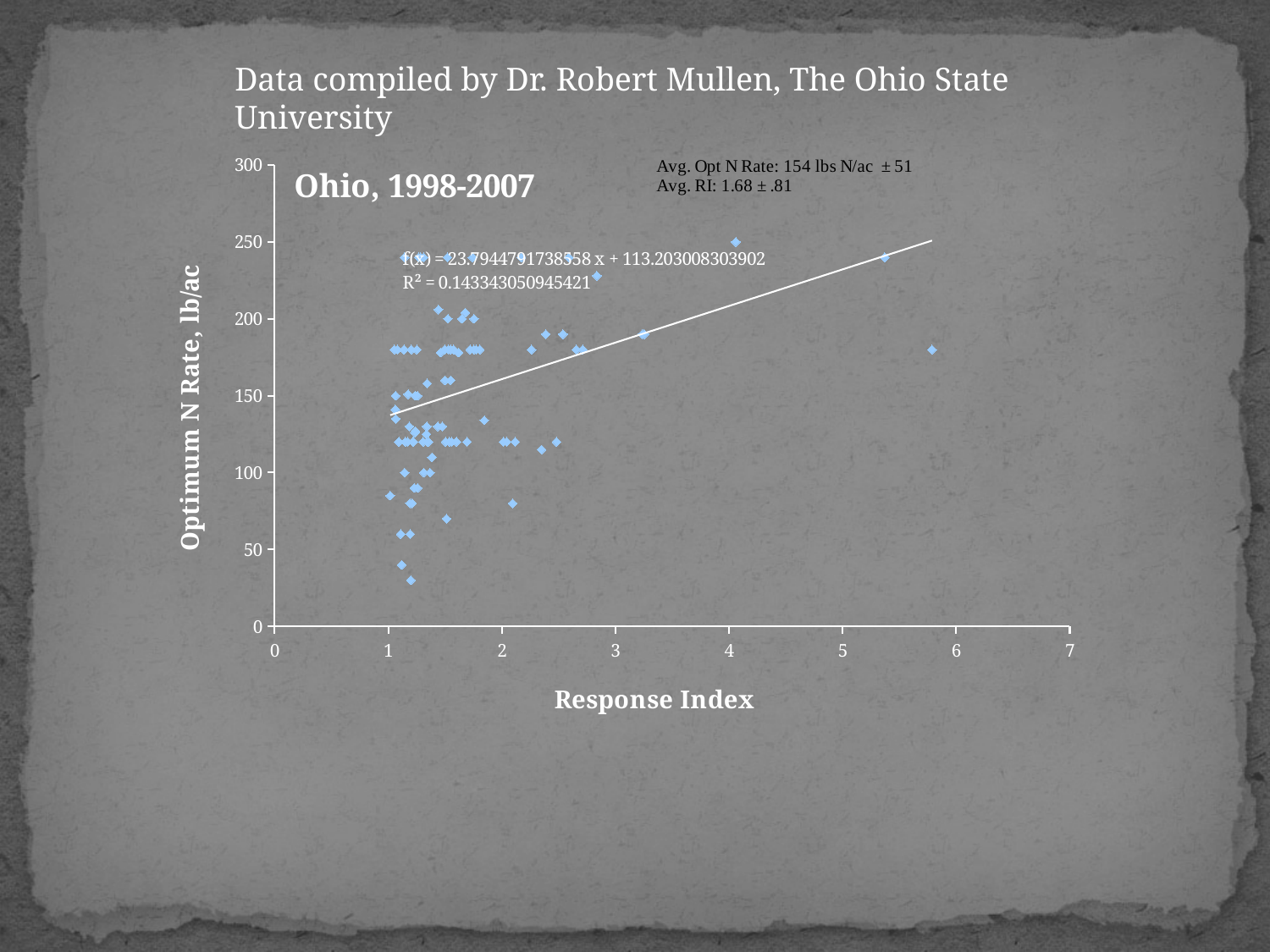
Is the Optimum N Rate of the data point at a Response Index of about 5.8 greater or less than 150? greater What is the intercept of the trendline equation printed on the chart? 113.203008303902 Does the fitted trendline rise or fall as the Response Index increases? Rises What kind of chart is shown on the slide? Scatter chart What R² value is printed on the chart for the trendline? R² = 0.143343050945421 What is the slope of the trendline equation printed on the chart? 23.7944791738558 What is the title of the chart? Ohio, 1998-2007 What is the label of the x axis? Response Index What average Response Index (RI) is stated in the annotation on the chart? 1.68 ± .81 What average optimum N rate is stated in the annotation on the chart? 154 lbs N/ac ± 51 What is the highest value shown on the y axis? 300 Is the Optimum N Rate of the data point at a Response Index of about 4 greater or less than 200? greater